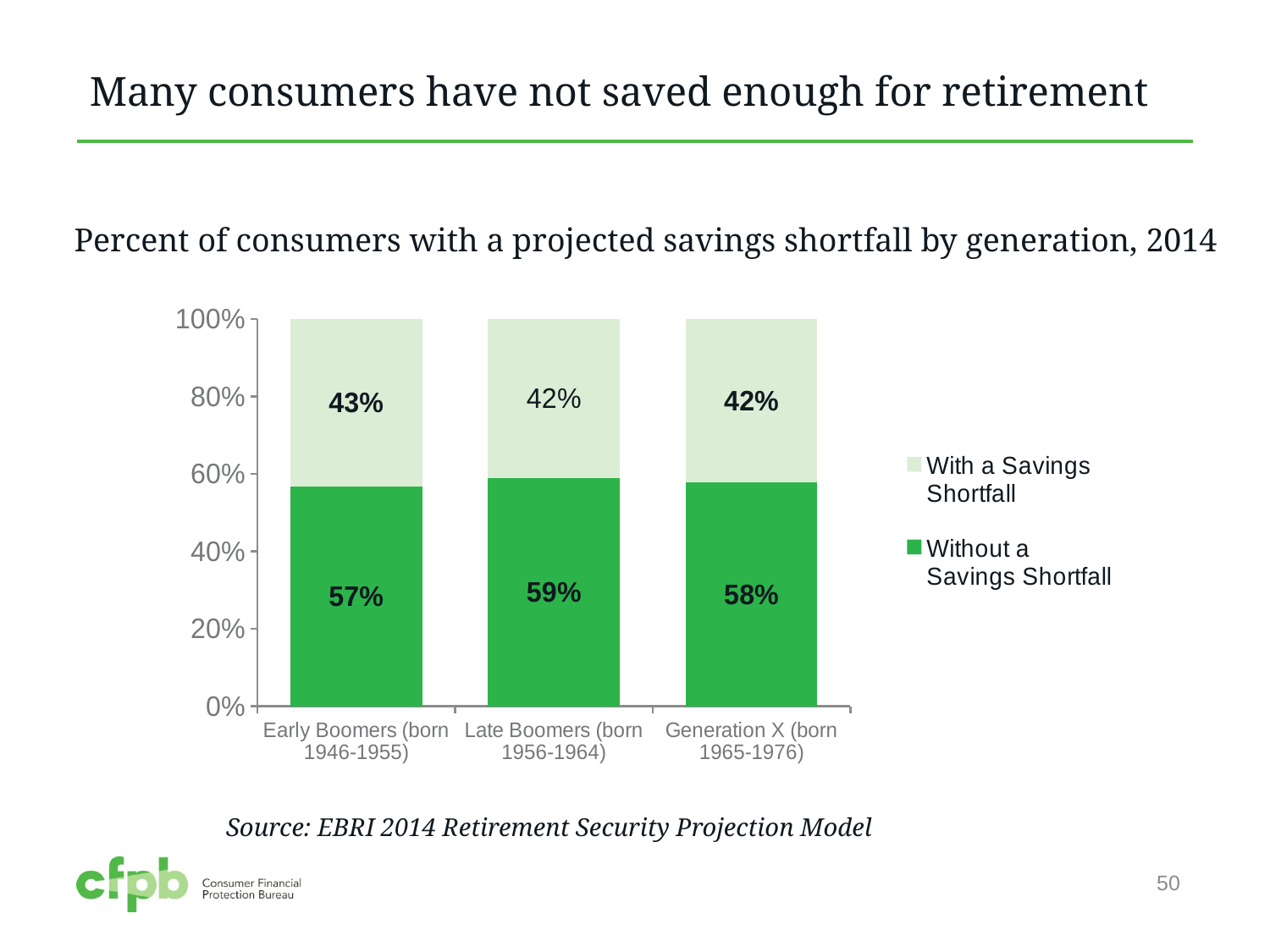
What is the difference between the Without a Savings Shortfall percentages for Late Boomers and Early Boomers? 2% Which is larger: the Without a Savings Shortfall share for Generation X or for Early Boomers? Generation X How many series does the legend list? 2 What kind of chart is shown on the slide? Stacked bar chart What percentage of Late Boomers (born 1956-1964) are shown Without a Savings Shortfall? 59% What is the total of the stacked bar for Generation X (born 1965-1976)? 100% Which legend entry is shown in dark green? Without a Savings Shortfall What percentage of Early Boomers (born 1946-1955) are shown With a Savings Shortfall? 43% What percentage of Generation X (born 1965-1976) are shown With a Savings Shortfall? 42% How many generations are shown on the x axis? 3 Which generation has the highest percentage Without a Savings Shortfall? Late Boomers (born 1956-1964) Which generation has the highest percentage With a Savings Shortfall? Early Boomers (born 1946-1955)